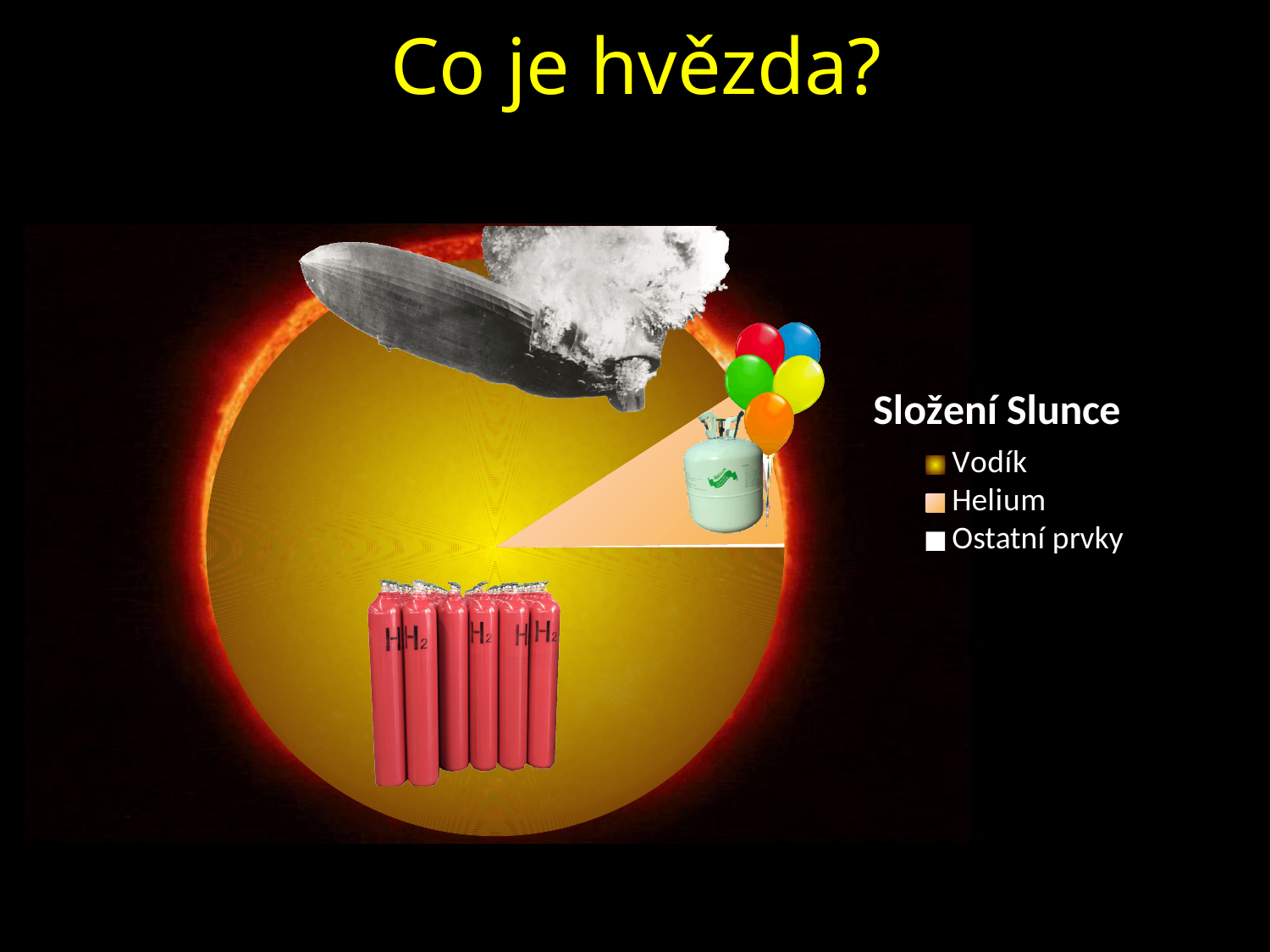
Which category has the smallest slice of the pie? Ostatní prvky Which slice is larger, Vodík or Helium? Vodík What is the title of the chart? Složení Slunce Which legend entry is shown in the peach/orange colour? Helium Which slice is larger, Helium or Ostatní prvky? Helium Which category has the largest slice of the pie? Vodík How many entries does the chart's legend list? 3 How many slices does the pie chart have? 3 What kind of chart is shown on the slide? pie chart